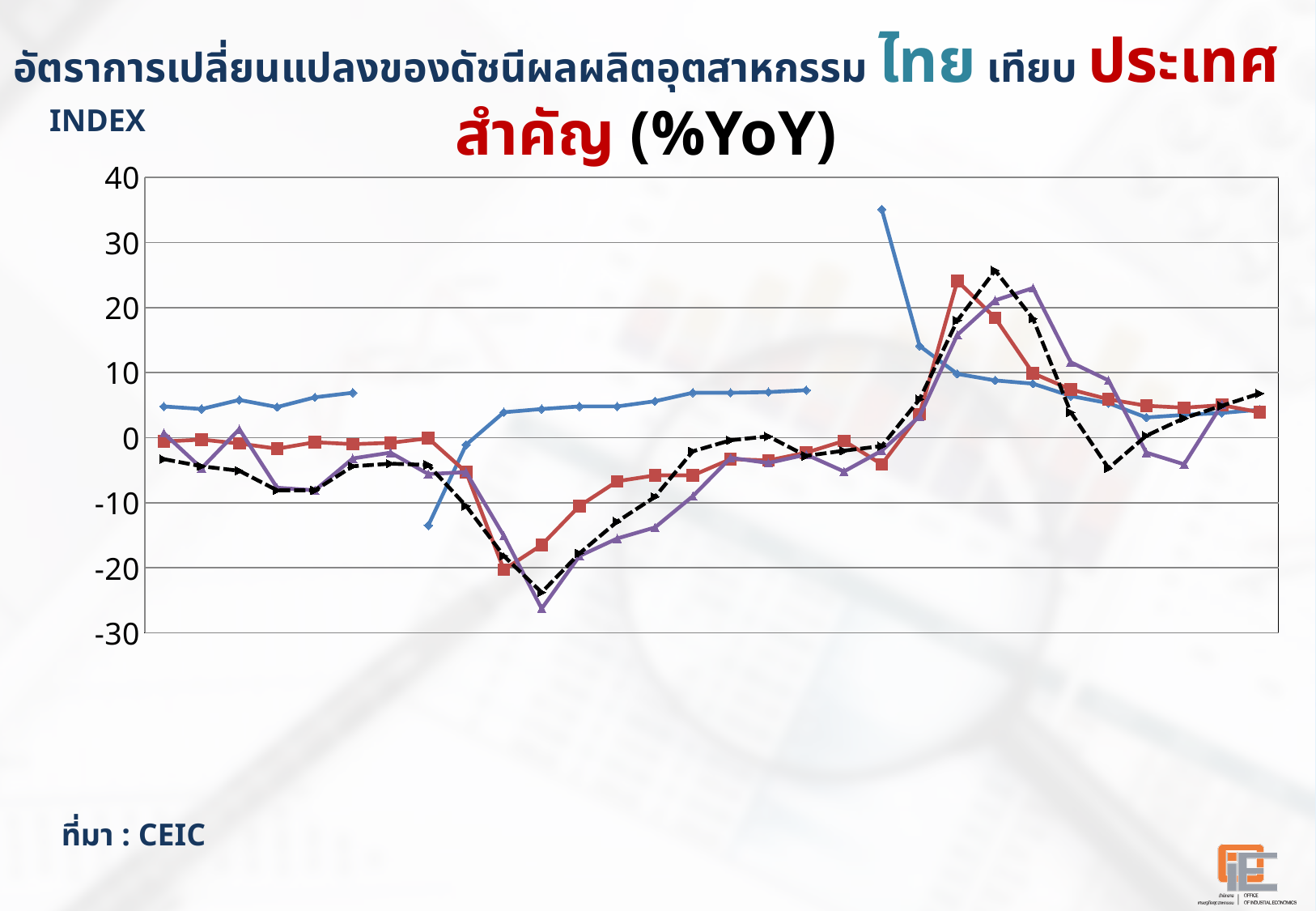
Is the lowest point of the red line greater or less than -10? less Is the highest point of the blue line greater or less than 30? greater Is the highest point of the red line greater or less than 20? greater What source is cited below the chart? CEIC How many lines are plotted on the chart? 4 What kind of chart is shown on the slide? Line chart What is the highest value shown on the vertical axis? 40 Which line reaches the highest point on the chart? The blue line